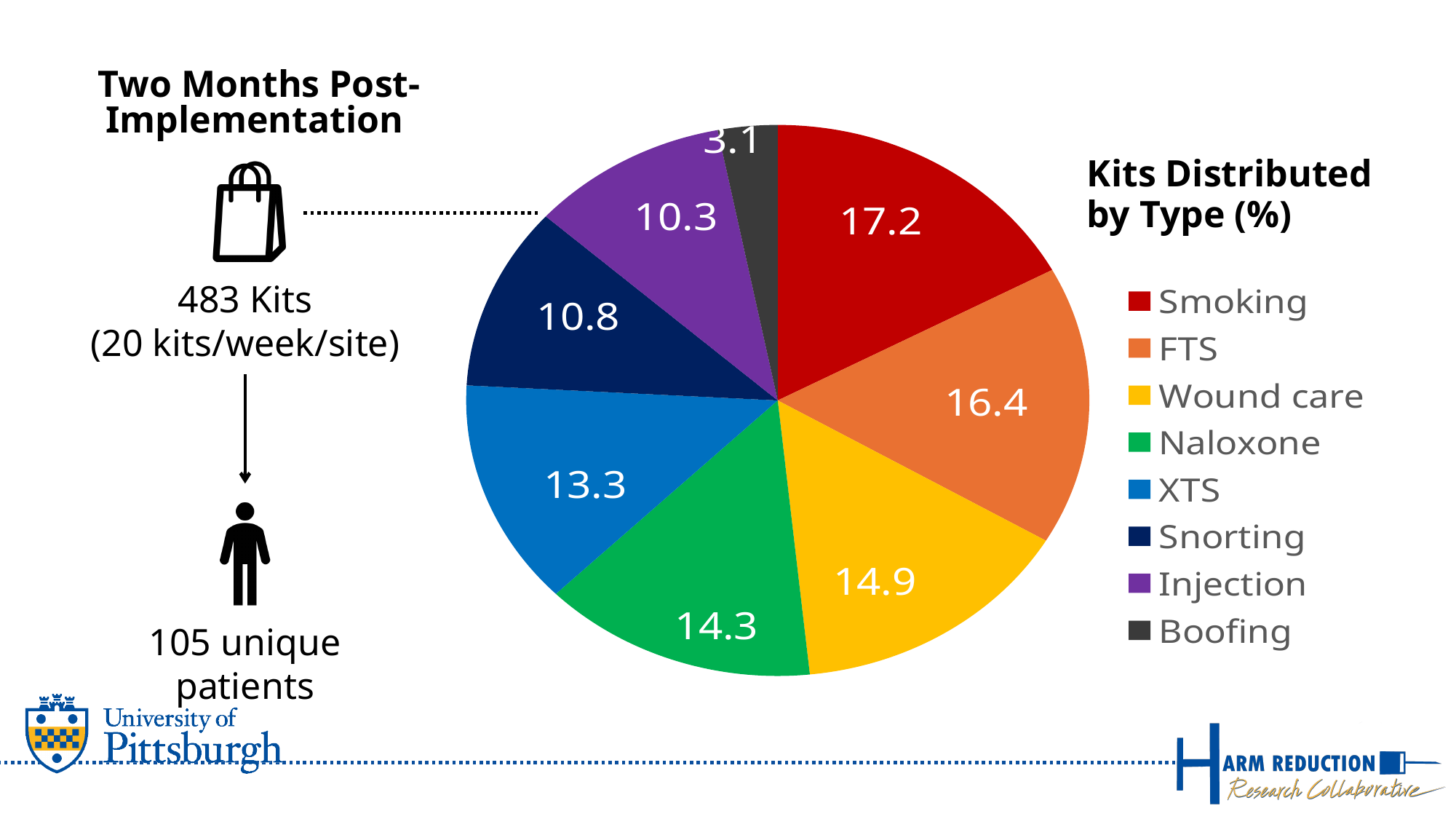
Which kit type has the smallest share of kits distributed? Boofing What percentage of kits distributed were Boofing kits? 3.1 What is the title of the chart? Kits Distributed by Type (%) Which has a larger share of kits distributed, Wound care or Injection? Wound care Which kit type has the largest share of kits distributed? Smoking What is the difference in percentage points between Smoking and FTS kits? 0.8 What kind of chart is shown on the slide? Pie chart What colour represents Snorting in the pie chart? Dark navy blue What percentage of kits distributed were XTS kits? 13.3 What percentage of kits distributed were Smoking kits? 17.2 How many kit types are shown in the pie chart? 8 What percentage of kits distributed were Naloxone kits? 14.3